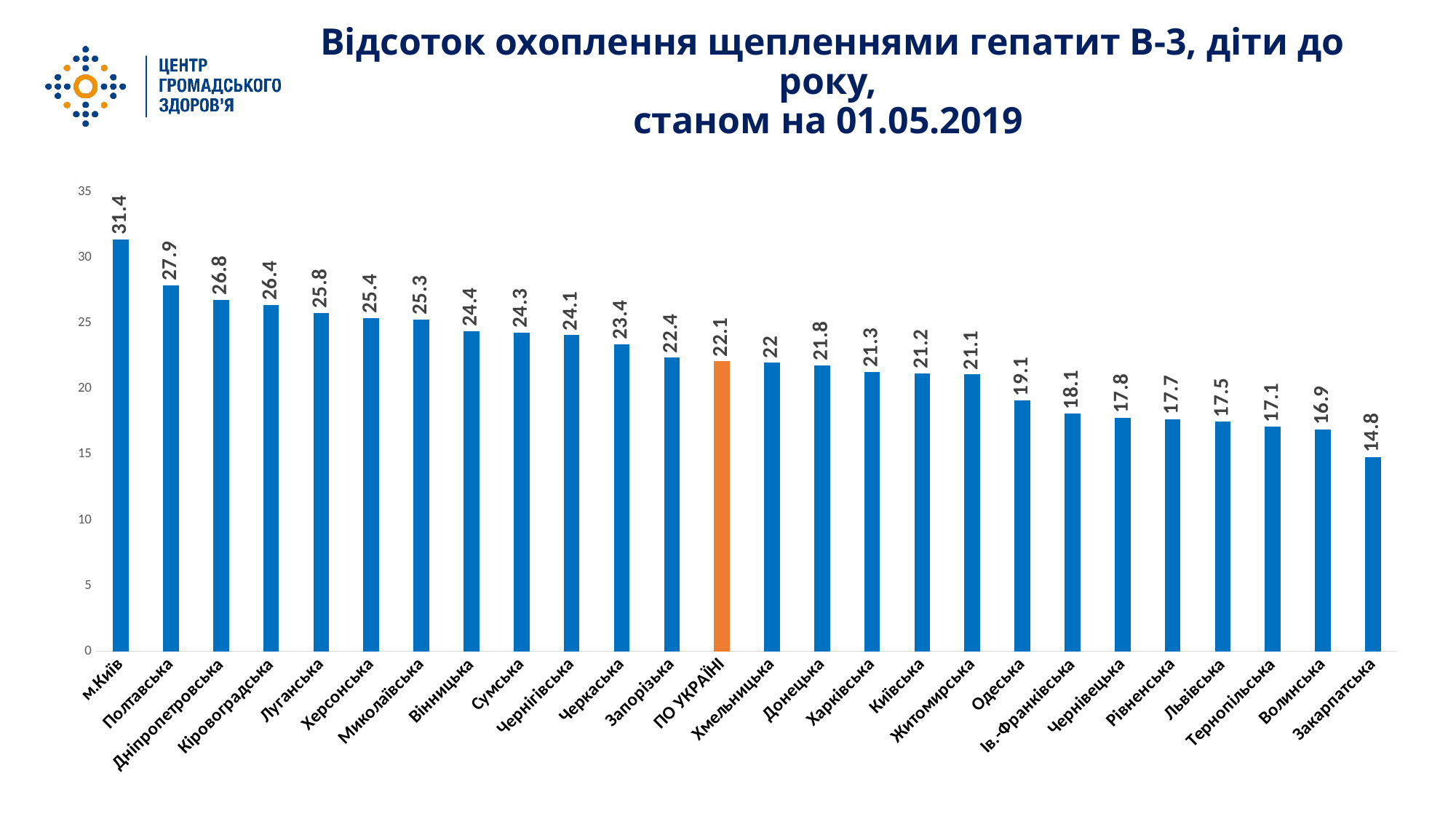
What is the value for ПО УКРАЇНІ? 22.1 Is the value for Хмельницька greater or less than 20? greater Which category has the lowest value? Закарпатська Which category has the highest value? м.Київ How many categories are shown on the x axis? 26 What is the value for Одеська? 19.1 What is the difference between the values for м.Київ and Закарпатська? 16.6 What is the difference between the values for Полтавська and ПО УКРАЇНІ? 5.8 Which is larger, the value for Луганська or the value for Волинська? Луганська What kind of chart is shown on the slide? bar chart What is the value for м.Київ? 31.4 Which bar is coloured orange instead of blue? ПО УКРАЇНІ